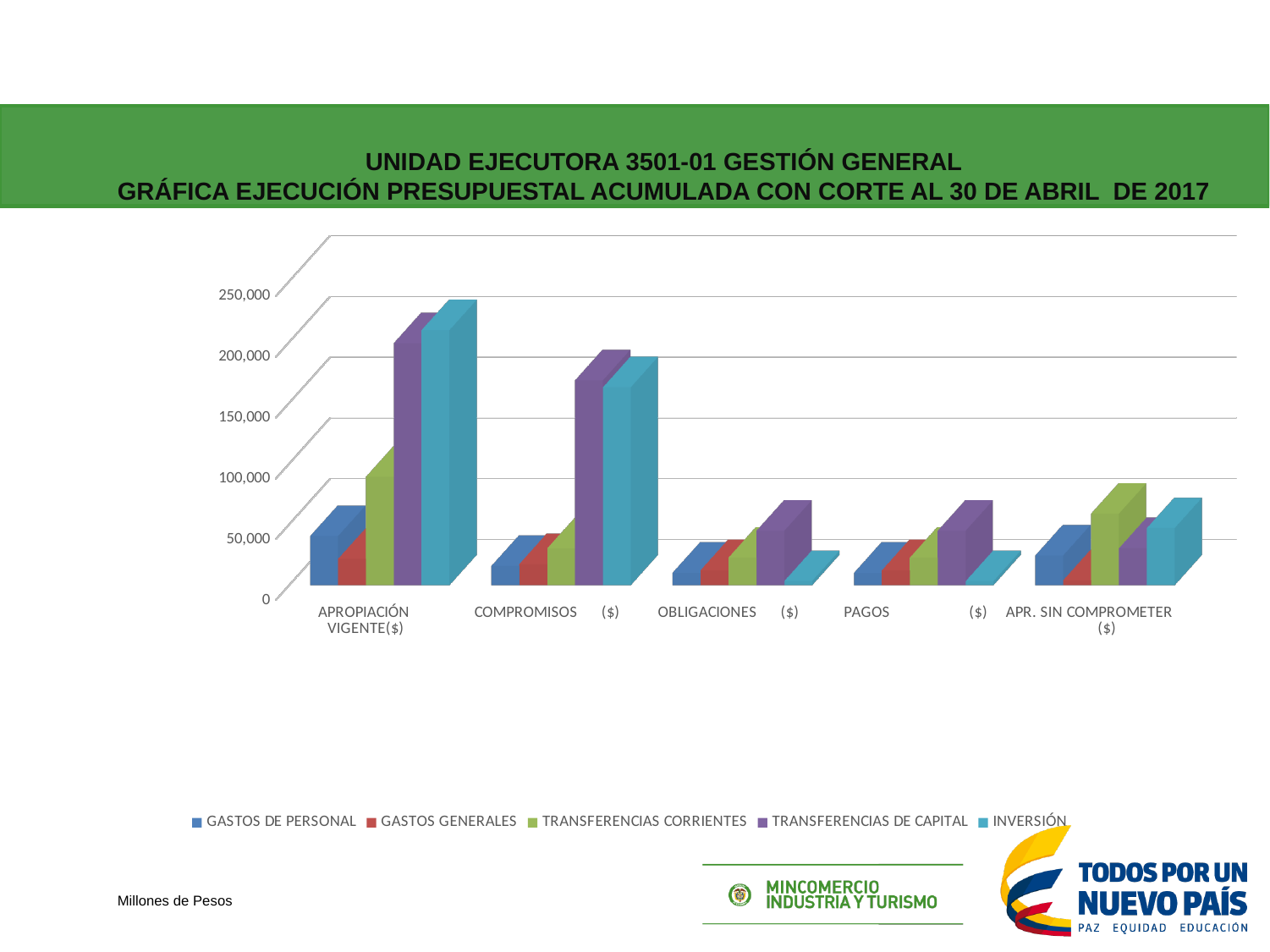
How many series does the chart legend list? 5 How many categories are shown along the x axis of the chart? 5 What kind of chart is shown on the slide? Bar chart In the APR. SIN COMPROMETER ($) category, which is larger: TRANSFERENCIAS CORRIENTES or GASTOS GENERALES? TRANSFERENCIAS CORRIENTES In which category is the INVERSIÓN bar the tallest? APROPIACIÓN VIGENTE($) What unit of measurement is stated for the chart values at the bottom of the slide? Millones de Pesos Is the value for INVERSIÓN in OBLIGACIONES ($) greater or less than 50,000? less Is the value for TRANSFERENCIAS CORRIENTES in APROPIACIÓN VIGENTE($) greater or less than 50,000? greater Which series has the lowest bar in the APROPIACIÓN VIGENTE($) category? GASTOS GENERALES Is the value for TRANSFERENCIAS DE CAPITAL in COMPROMISOS ($) greater or less than 150,000? greater In the OBLIGACIONES ($) category, which is larger: TRANSFERENCIAS DE CAPITAL or INVERSIÓN? TRANSFERENCIAS DE CAPITAL